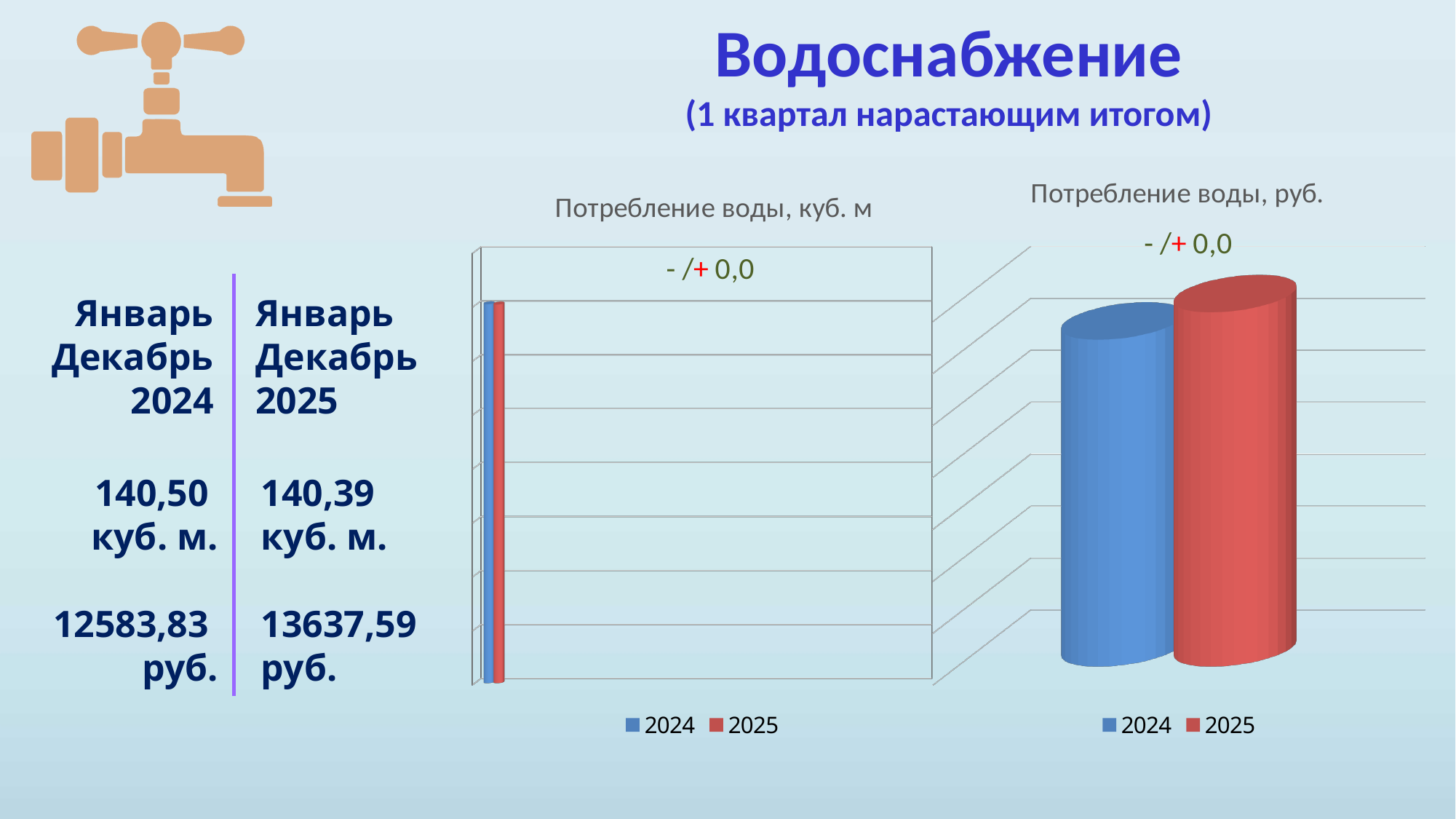
In the chart titled "Потребление воды, руб.", which series has the lowest bar? 2024 What is the title of the chart on the left side of the slide? Потребление воды, куб. м In the chart titled "Потребление воды, куб. м", how many bars are plotted? 2 In the chart titled "Потребление воды, руб.", how many series does the legend list? 2 What kind of chart is the chart titled "Потребление воды, руб."? bar chart What kind of chart is the chart titled "Потребление воды, куб. м"? bar chart In the chart titled "Потребление воды, руб.", how many bars are plotted? 2 In the chart titled "Потребление воды, куб. м", how many series does the legend list? 2 In the chart titled "Потребление воды, руб.", which is larger, the bar for 2024 or the bar for 2025? 2025 In the chart titled "Потребление воды, руб.", which series has the highest bar? 2025 In the chart titled "Потребление воды, руб.", what colour represents the 2024 series? blue